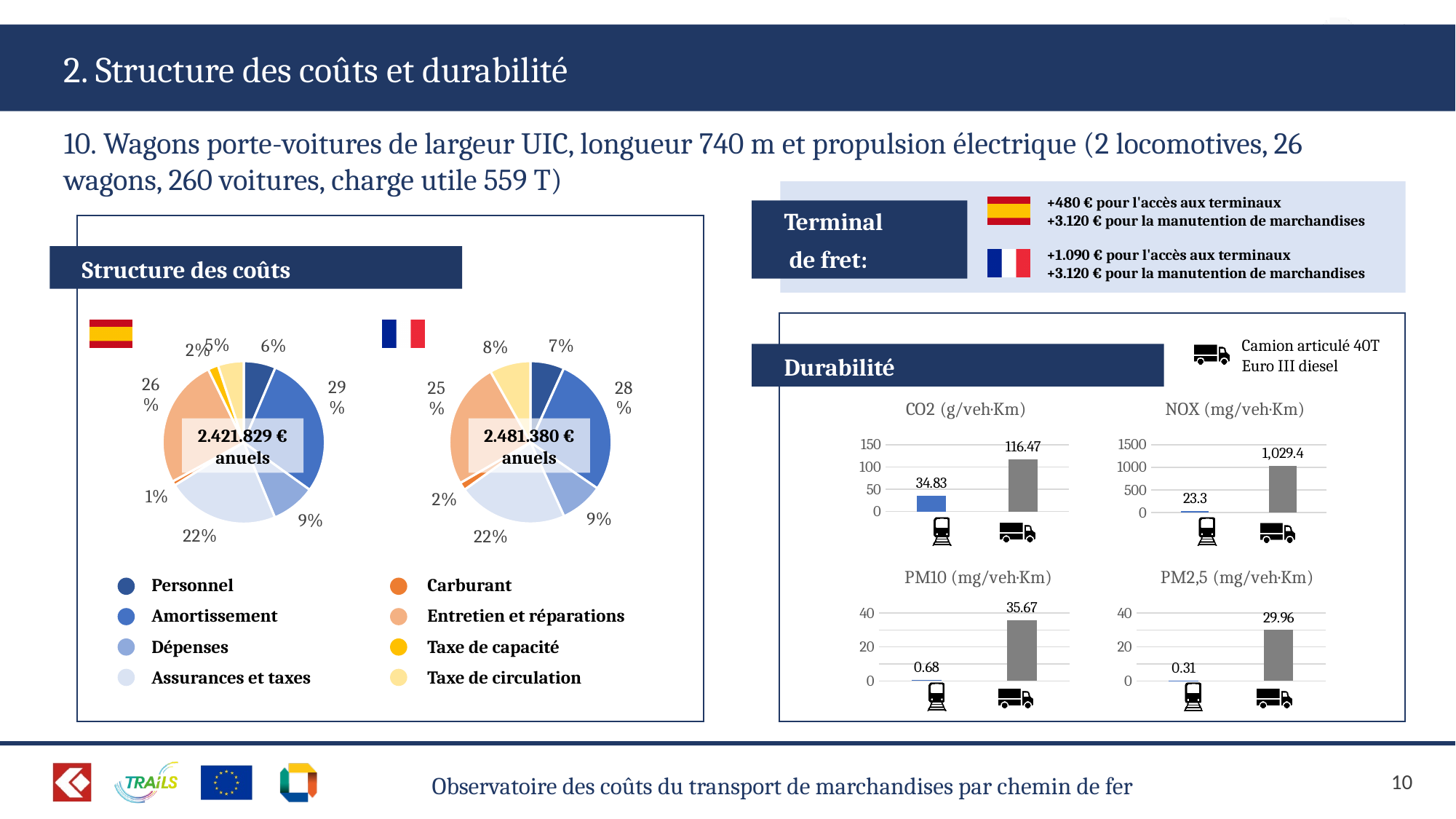
In the NOX (mg/veh·Km) chart, what is the value for the train? 23.3 In the PM2,5 (mg/veh·Km) chart, which has the larger value, the train or the truck? The truck In the Spanish cost structure pie chart (left pie), which category has the largest slice? Amortissement In the Spanish cost structure pie chart (left pie), what is the difference in percentage points between Amortissement and Entretien et réparations? 3 percentage points In the French cost structure pie chart (right pie), which category has the smallest slice? Carburant In the Spanish cost structure pie chart (left pie), what share is Amortissement? 29% In the French cost structure pie chart (right pie), what share is Entretien et réparations? 25% What kind of chart is the CO2 (g/veh·Km) chart? Bar chart In the PM10 (mg/veh·Km) chart, what is the difference between the truck value and the train value? 34.99 How many bars are shown in the NOX (mg/veh·Km) chart? 2 In the CO2 (g/veh·Km) chart, what is the value for the truck? 116.47 What annual total is shown in the centre of the Spanish cost structure pie chart (left pie)? 2.421.829 € anuels